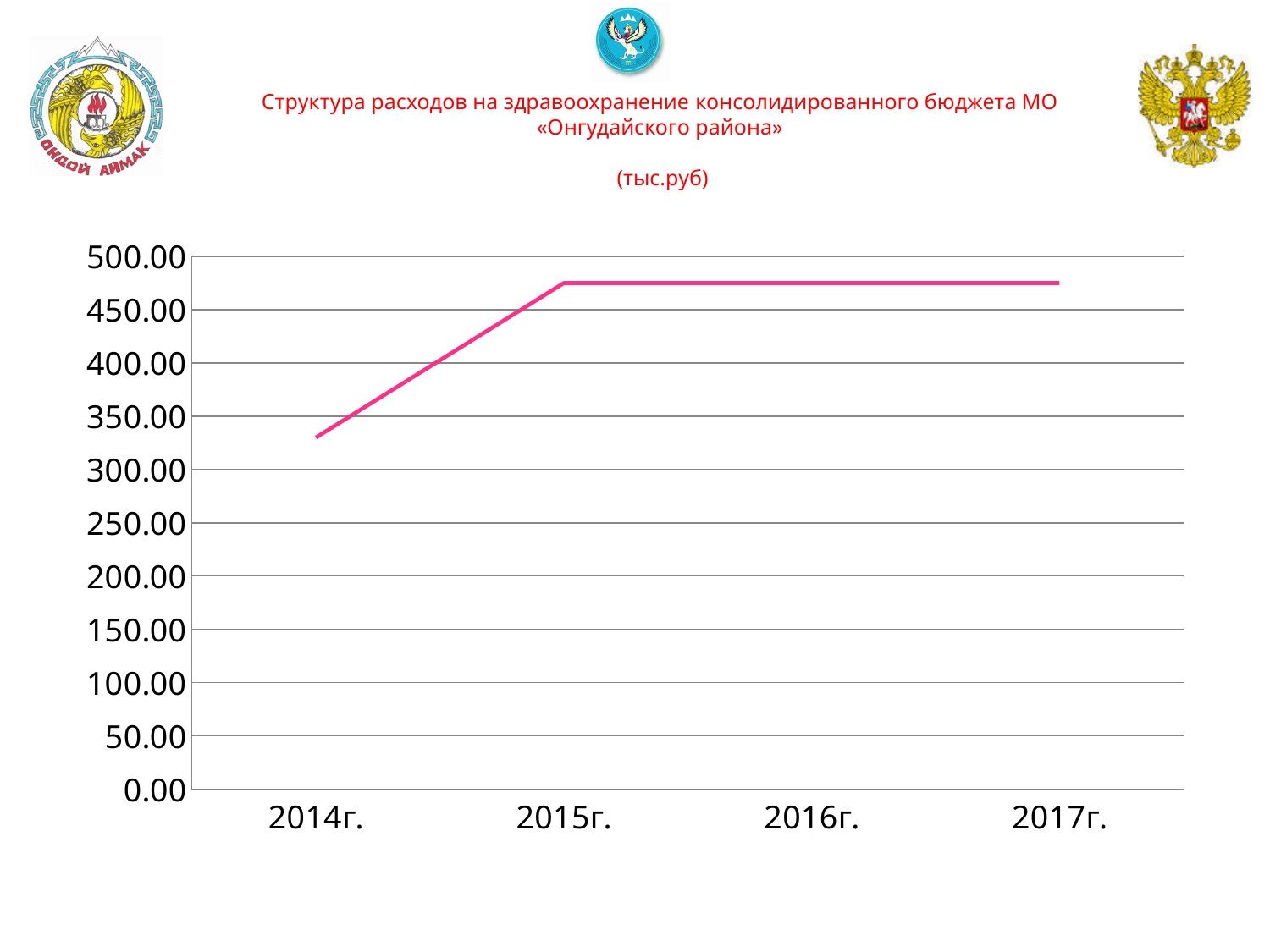
Is the value for 2017г. greater or less than 500? less Which is larger, the value for 2014г. or the value for 2015г.? 2015г. Does the line rise or fall from 2014г. to 2015г.? rise How many years are plotted along the x axis of the chart? 4 What unit is given in the chart title? тыс.руб Is the value for 2014г. greater or less than 300? greater Is the value for 2016г. greater or less than 400? greater What colour is the line on the chart? pink Which year has the lowest value on the chart? 2014г. What kind of chart is shown on the slide? line chart